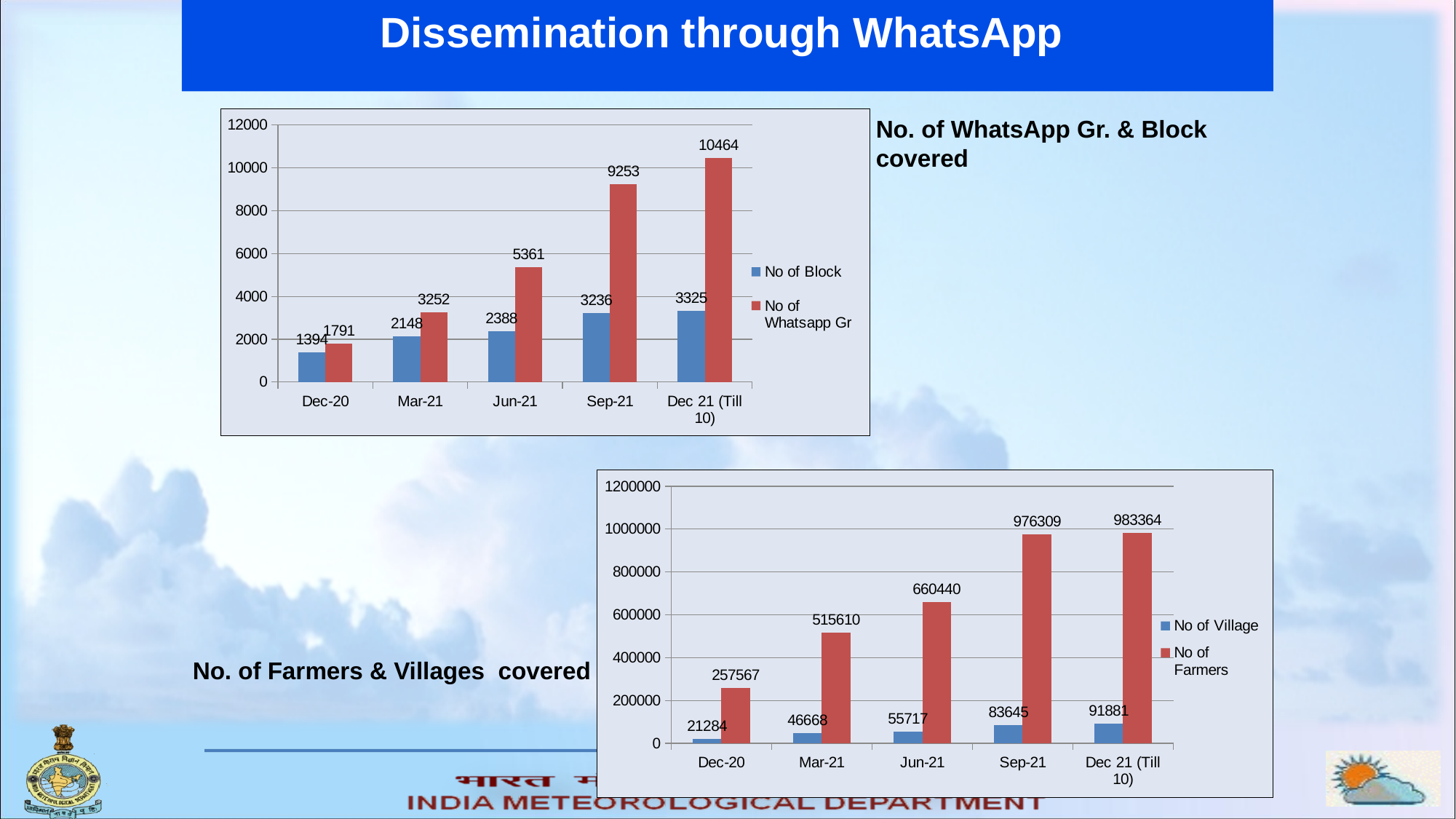
In the top chart (No. of WhatsApp Gr. & Block covered), what is the number of blocks for Dec-20? 1394 In the bottom chart (No. of Farmers & Villages covered), what is the number of villages for Sep-21? 83645 In the top chart (No. of WhatsApp Gr. & Block covered), how many series does the legend list? 2 In the bottom chart (No. of Farmers & Villages covered), what is the difference in the number of farmers between Mar-21 and Dec-20? 258043 In the top chart (No. of WhatsApp Gr. & Block covered), what is the number of WhatsApp groups for Sep-21? 9253 In the top chart (No. of WhatsApp Gr. & Block covered), does the number of WhatsApp groups rise or fall from Dec-20 to Dec 21 (Till 10)? rise In the top chart (No. of WhatsApp Gr. & Block covered), which period has the highest number of WhatsApp groups? Dec 21 (Till 10) In the bottom chart (No. of Farmers & Villages covered), which period has the lowest number of villages? Dec-20 What kind of chart is the bottom chart (No. of Farmers & Villages covered)? bar chart In the bottom chart (No. of Farmers & Villages covered), how many periods are shown on the x axis? 5 In the top chart (No. of WhatsApp Gr. & Block covered), what is the difference between the number of WhatsApp groups and the number of blocks for Jun-21? 2973 In the bottom chart (No. of Farmers & Villages covered), what is the number of farmers for Jun-21? 660440